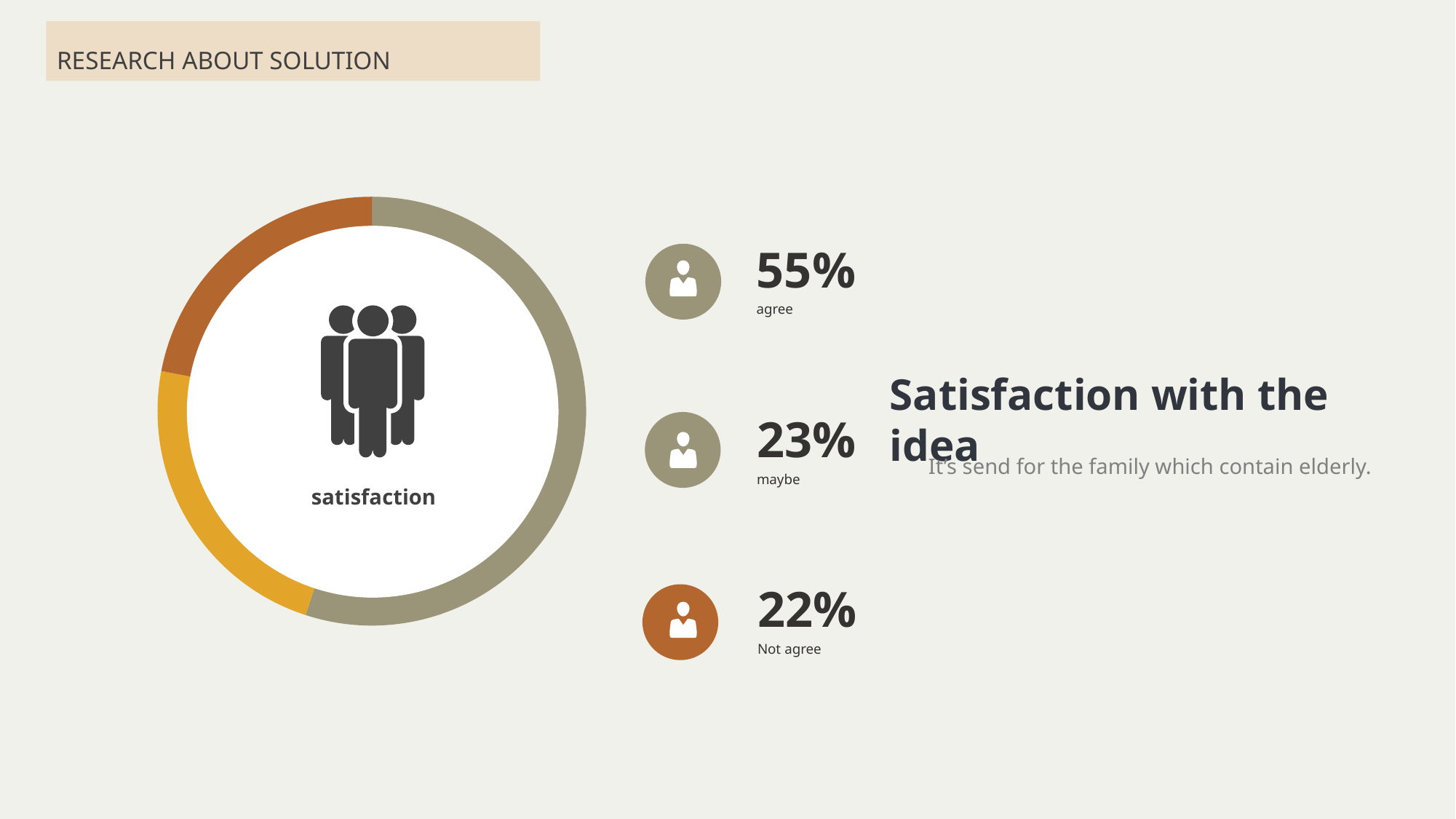
What percentage of respondents do not agree? 22% What is the difference in percentage points between agree and Not agree? 33 Which response category has the smallest share? Not agree What percentage of respondents agree with the idea? 55% Which response category has the largest share? agree What percentage of respondents answered maybe? 23% Which is larger, the share for agree or the share for maybe? agree How many response categories are shown in the chart? 3 What colour is the segment representing Not agree? orange-brown What is the difference in percentage points between agree and maybe? 32 What kind of chart is used to show the satisfaction results? donut chart What word is written in the centre of the donut chart? satisfaction